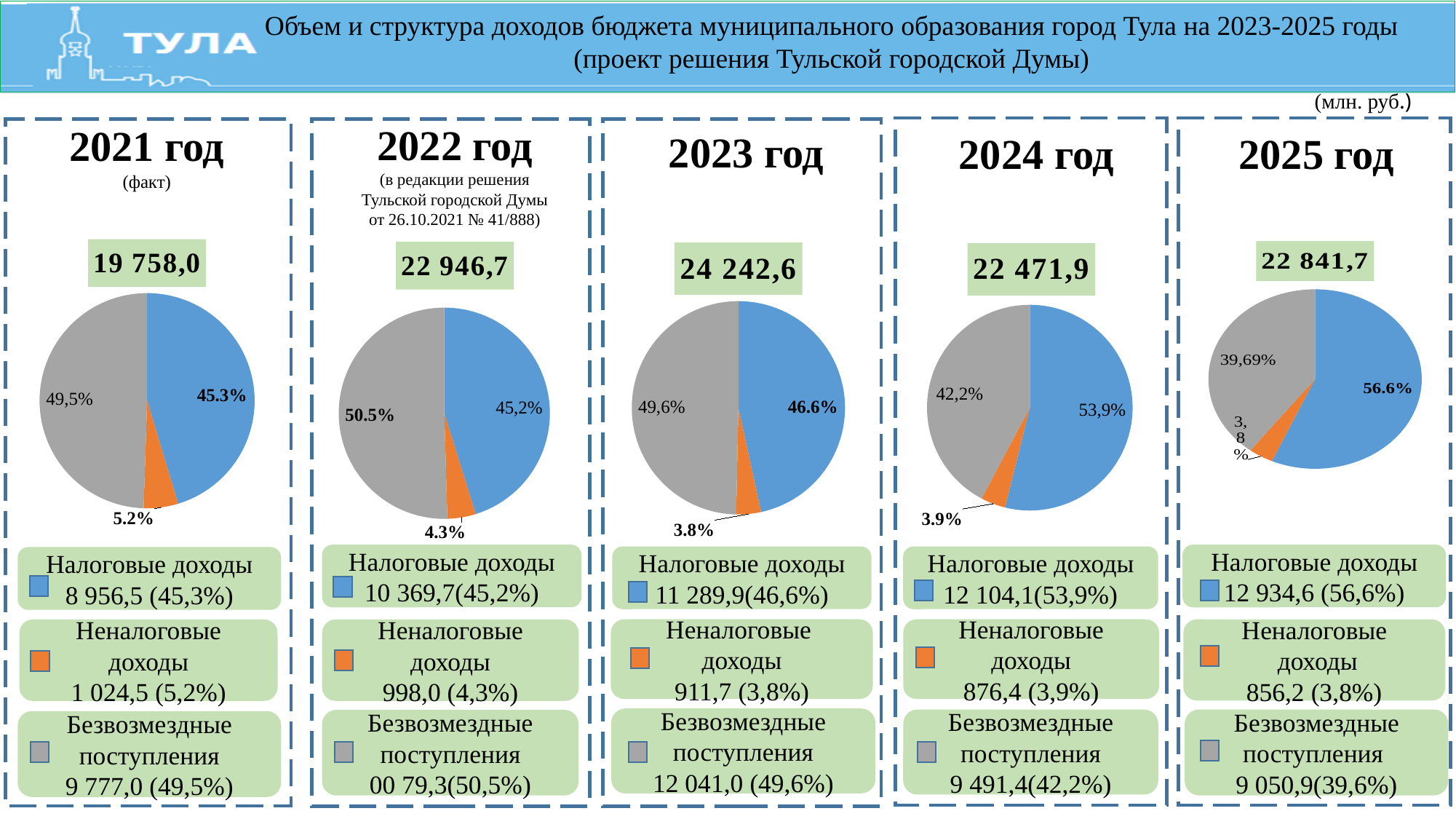
Which colour represents Неналоговые доходы in the pie charts? Orange In the 2023 год pie chart, which category has the smallest slice? Неналоговые доходы In the 2024 год chart, what is the value of Налоговые доходы in млн. руб.? 12 104,1 In the 2024 год chart, which is larger: Налоговые доходы or Безвозмездные поступления? Налоговые доходы How many slices does the 2023 год pie chart have? 3 In the 2025 год pie chart, what share is shown for Налоговые доходы? 56,6% What total budget income is shown above the 2021 год pie chart? 19 758,0 What type of chart is used for each year on the slide? Pie chart In the 2023 год chart, what is the difference between Безвозмездные поступления (12 041,0) and Налоговые доходы (11 289,9)? 751,1 In the 2021 год chart, what is the value of Неналоговые доходы in млн. руб.? 1 024,5 In the 2022 год pie chart, which category has the largest slice? Безвозмездные поступления In the 2021 год pie chart, what share is shown for Безвозмездные поступления? 49,5%